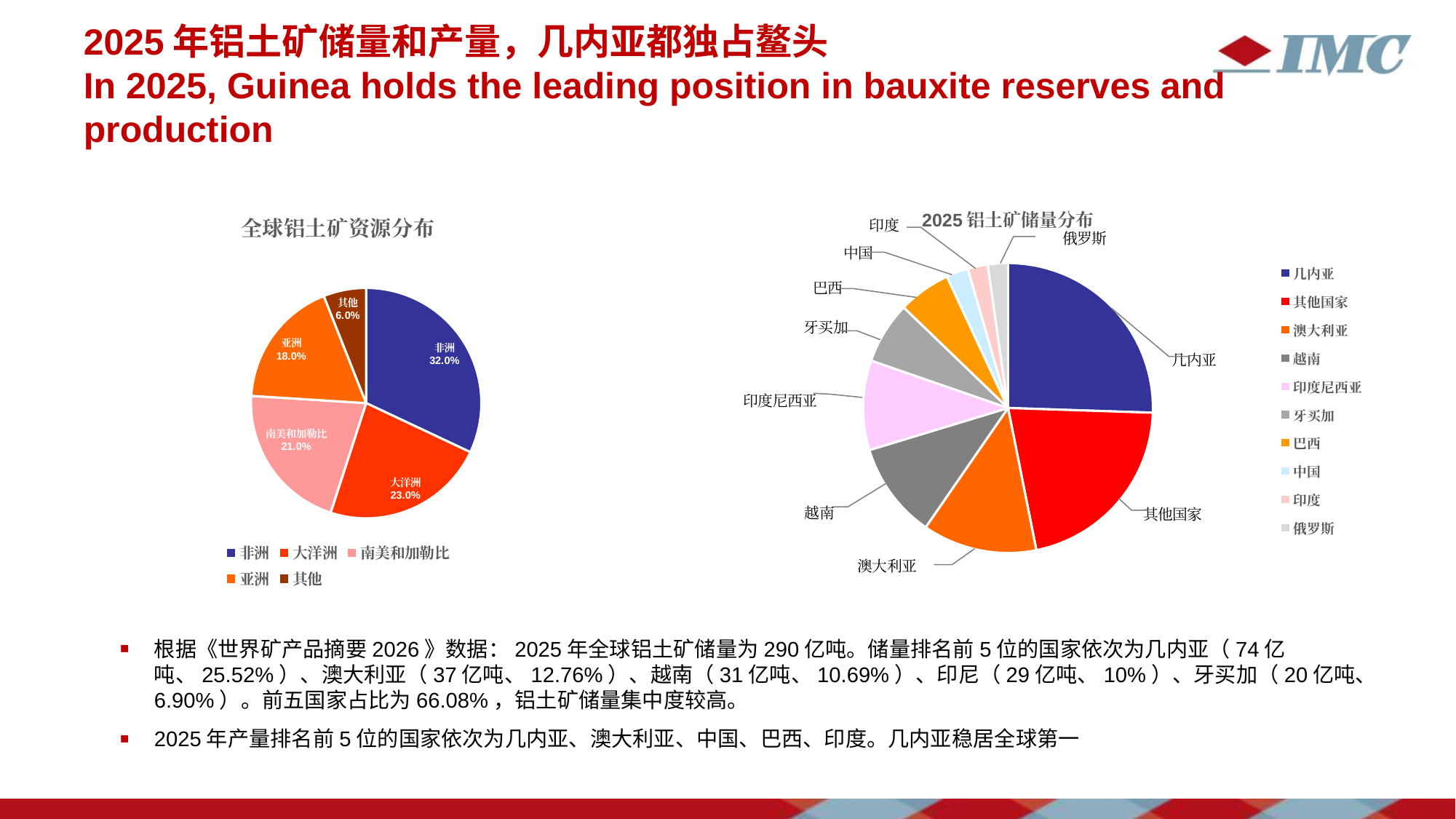
In the chart titled 2025 铝土矿储量分布, which slice is larger, 澳大利亚 or 巴西? 澳大利亚 In the chart titled 全球铝土矿资源分布, which category has the largest share? 非洲 In the chart titled 全球铝土矿资源分布, what is the share for 非洲? 32.0% In the chart titled 全球铝土矿资源分布, what is the difference in percentage points between 大洋洲 and 亚洲? 5.0 In the chart titled 全球铝土矿资源分布, which is larger, 大洋洲 or 南美和加勒比? 大洋洲 In the chart titled 全球铝土矿资源分布, what is the share for 其他? 6.0% In the chart titled 全球铝土矿资源分布, what is the share for 南美和加勒比? 21.0% In the chart titled 2025 铝土矿储量分布, which country has the largest slice? 几内亚 How many categories are shown in the chart titled 全球铝土矿资源分布? 5 What kind of chart is the chart titled 2025 铝土矿储量分布? Pie chart In the chart titled 全球铝土矿资源分布, which category has the smallest share? 其他 How many entries does the legend of the chart titled 2025 铝土矿储量分布 list? 10